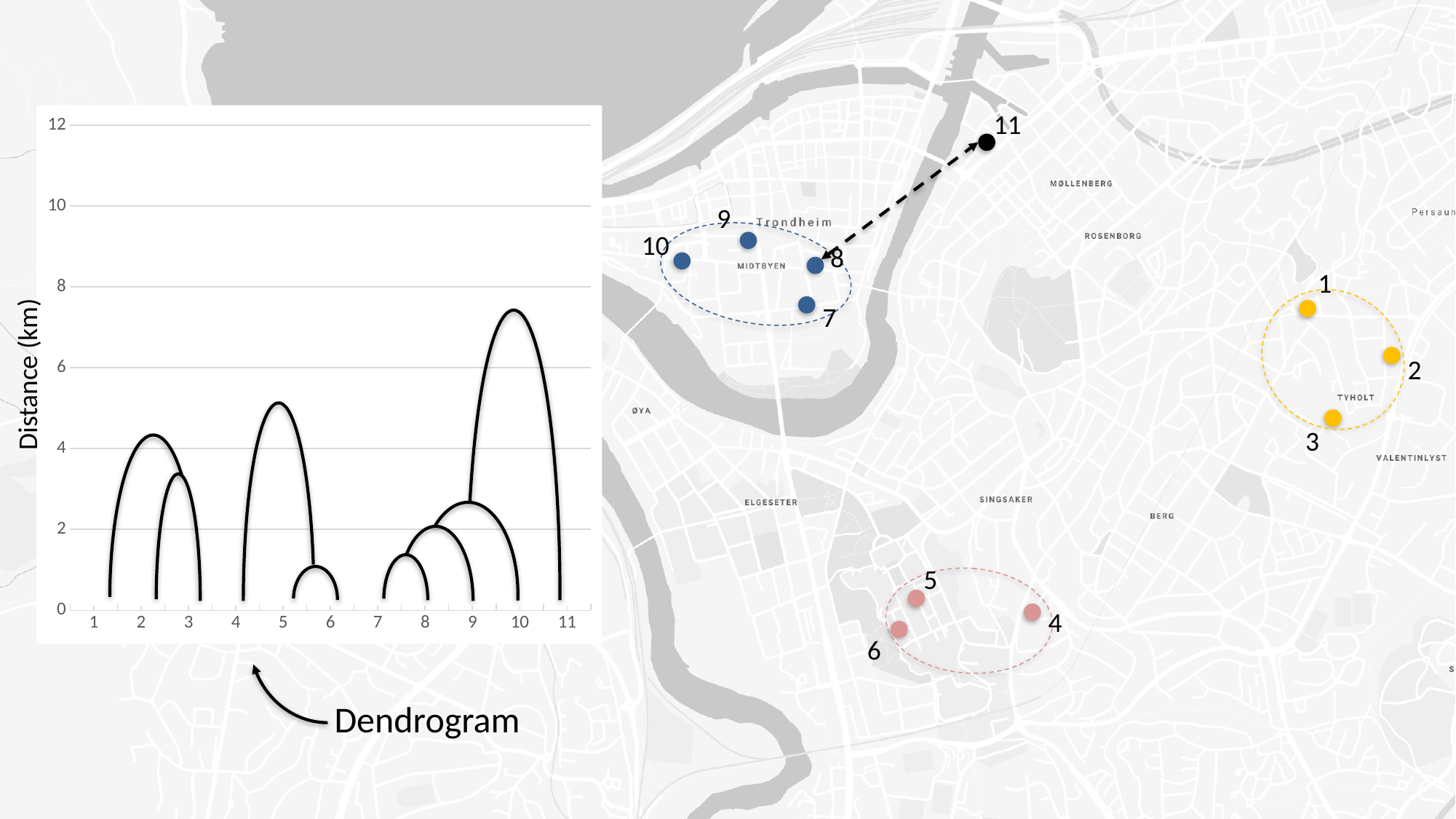
What is the title of the y axis of the dendrogram? Distance (km) How many points are labelled along the x axis of the dendrogram? 11 Is the height of the arc joining point 4 to points 5 and 6 greater or less than 4 km? greater Is the height of the arc joining points 2 and 3 greater or less than 4 km? less Is the height of the arc joining point 10 to points 7, 8 and 9 greater or less than 4 km? less Which is taller: the arc joining point 1 to points 2 and 3, or the arc joining point 4 to points 5 and 6? The arc joining point 4 to points 5 and 6 Which x-axis point is joined to the rest by the tallest arc in the dendrogram? 11 What kind of chart is shown on the left of the slide? Dendrogram What is the highest tick value shown on the y axis of the dendrogram? 12